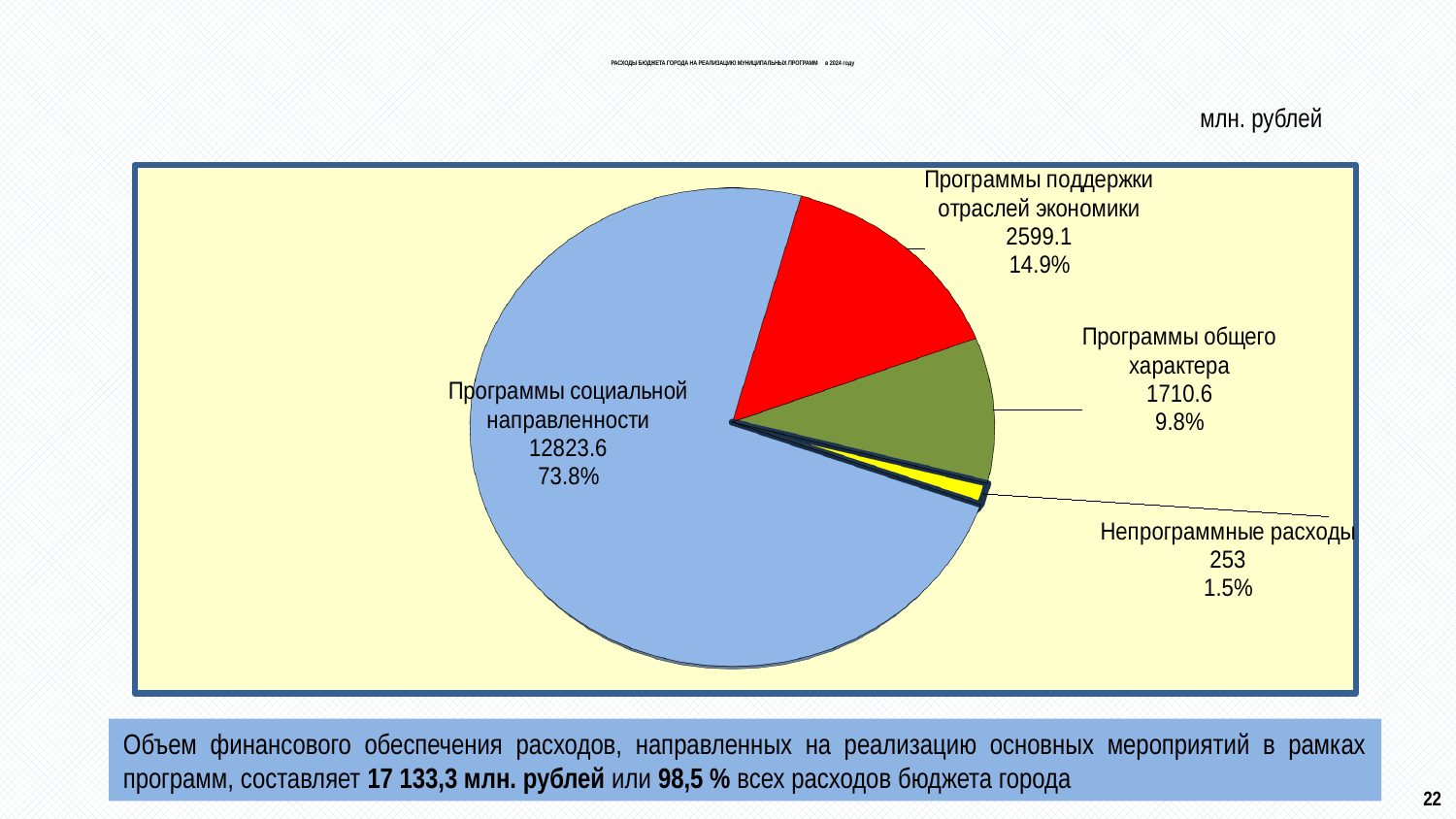
Which category has the largest slice of the pie? Программы социальной направленности Which is larger: Программы поддержки отраслей экономики or Программы общего характера? Программы поддержки отраслей экономики What is the value for Программы общего характера? 1710.6 Which category has the smallest slice of the pie? Непрограммные расходы What kind of chart is shown on the slide? pie chart What share of the pie does Непрограммные расходы take? 1.5% How many slices does the pie chart have? 4 What is the value for Программы социальной направленности? 12823.6 What is the difference between the values for Программы поддержки отраслей экономики and Программы общего характера? 888.5 What is the value for Непрограммные расходы? 253 What is the value for Программы поддержки отраслей экономики? 2599.1 What share of the pie does Программы социальной направленности take? 73.8%